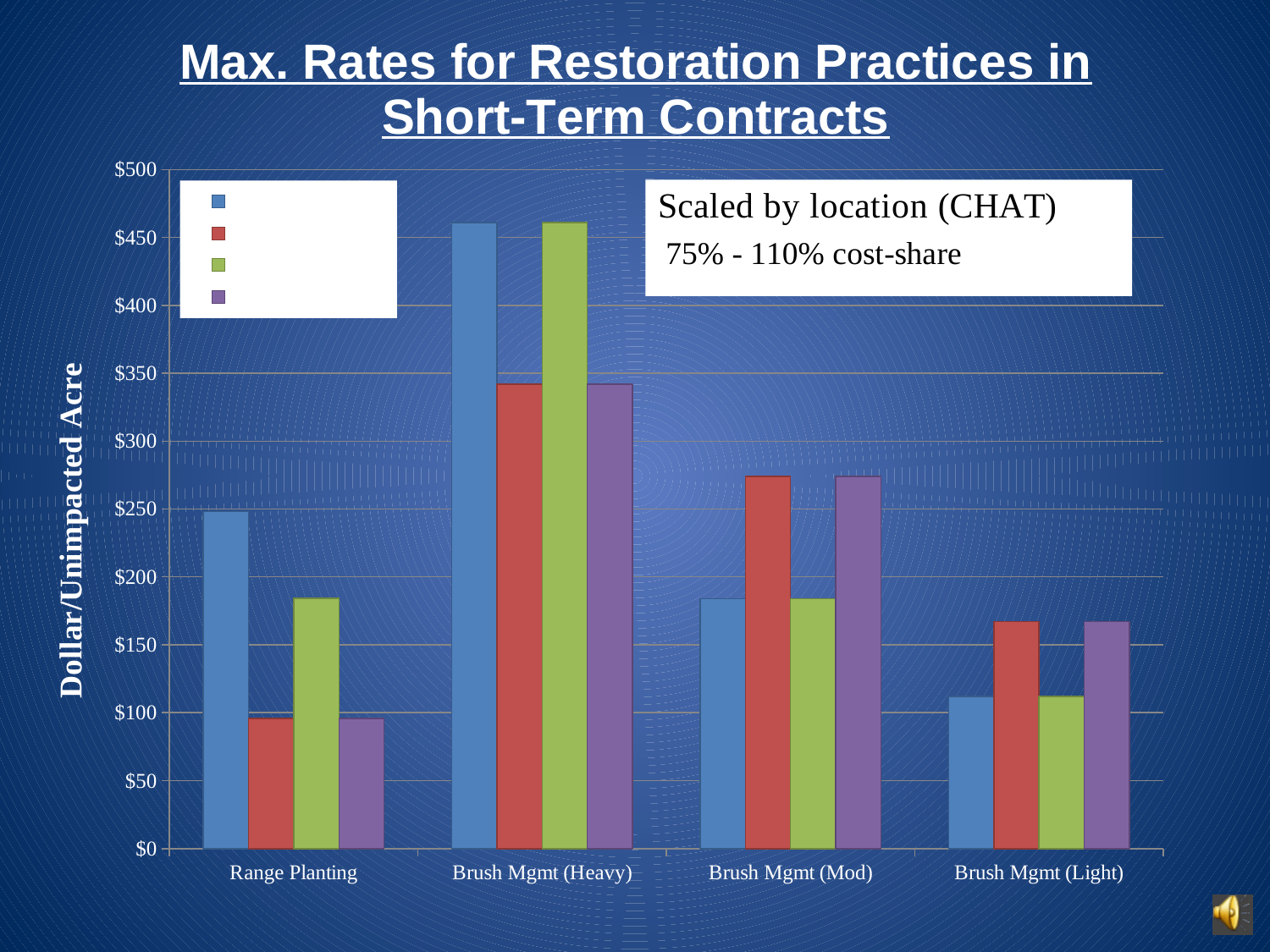
How many categories are shown on the x axis of the chart? 4 Is the value of the blue bar for Brush Mgmt (Heavy) greater or less than $450? greater Is the value of the red bar for Brush Mgmt (Light) greater or less than $150? greater Is the value of the blue bar for Brush Mgmt (Mod) greater or less than $200? less Which is larger: the blue bar for Range Planting or the blue bar for Brush Mgmt (Mod)? Range Planting What is the title of the chart's vertical axis? Dollar/Unimpacted Acre What kind of chart is shown on the slide? bar chart How many series does the chart's legend list? 4 Which category has the highest bar in the chart? Brush Mgmt (Heavy) Which category contains the lowest bar in the chart? Range Planting